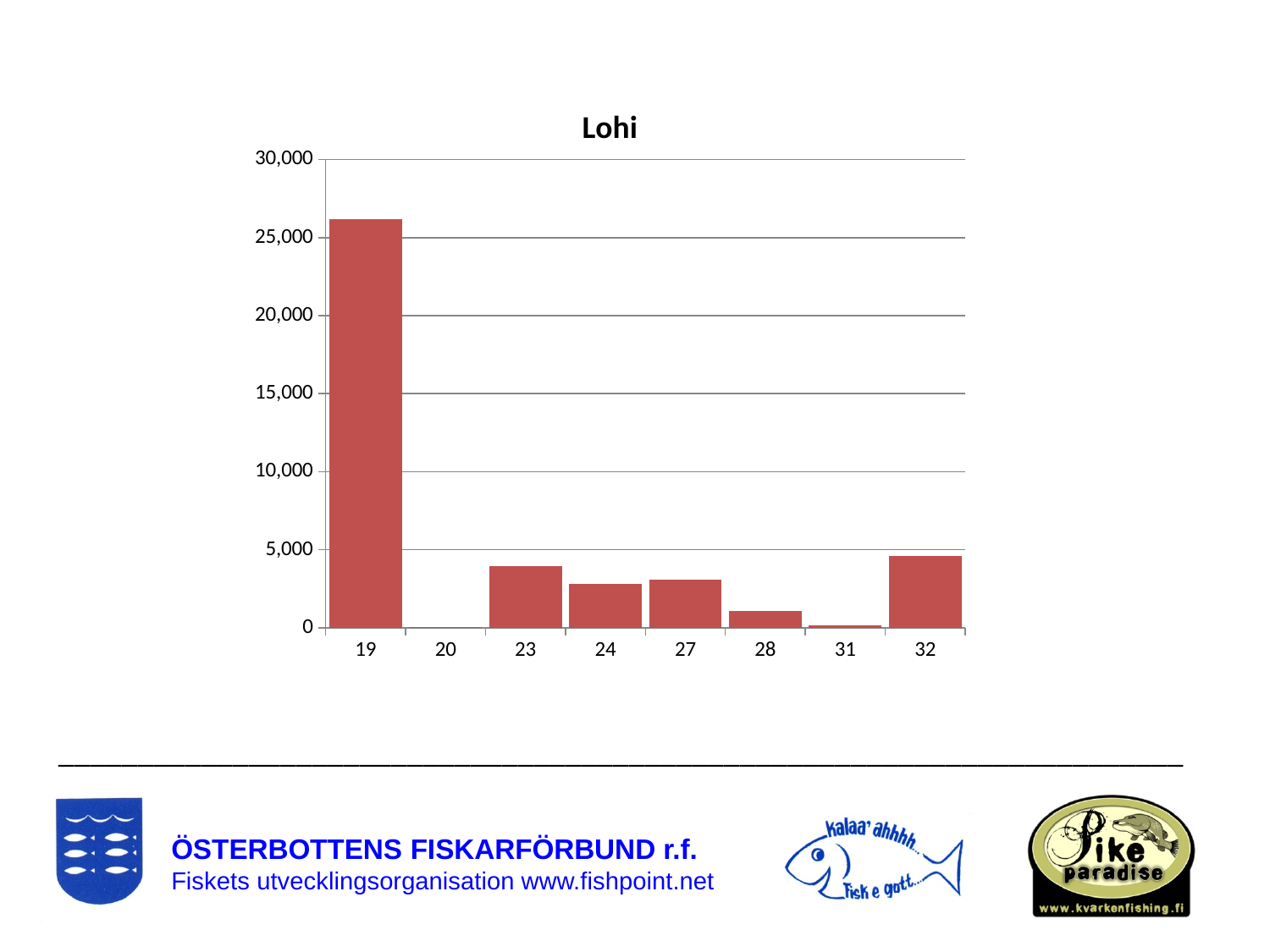
Is the value for category 32 greater or less than 5,000? less Which category has the highest value in the chart? 19 Is the value for category 23 greater or less than 5,000? less Which category has the lowest value in the chart? 20 What type of chart is shown on the slide? bar chart Is the value for category 28 greater or less than 5,000? less Which has the larger value, category 23 or category 24? 23 Which has the larger value, category 32 or category 28? 32 Which has the larger value, category 28 or category 31? 28 What is the title of the chart? Lohi How many categories are shown on the x axis of the chart? 8